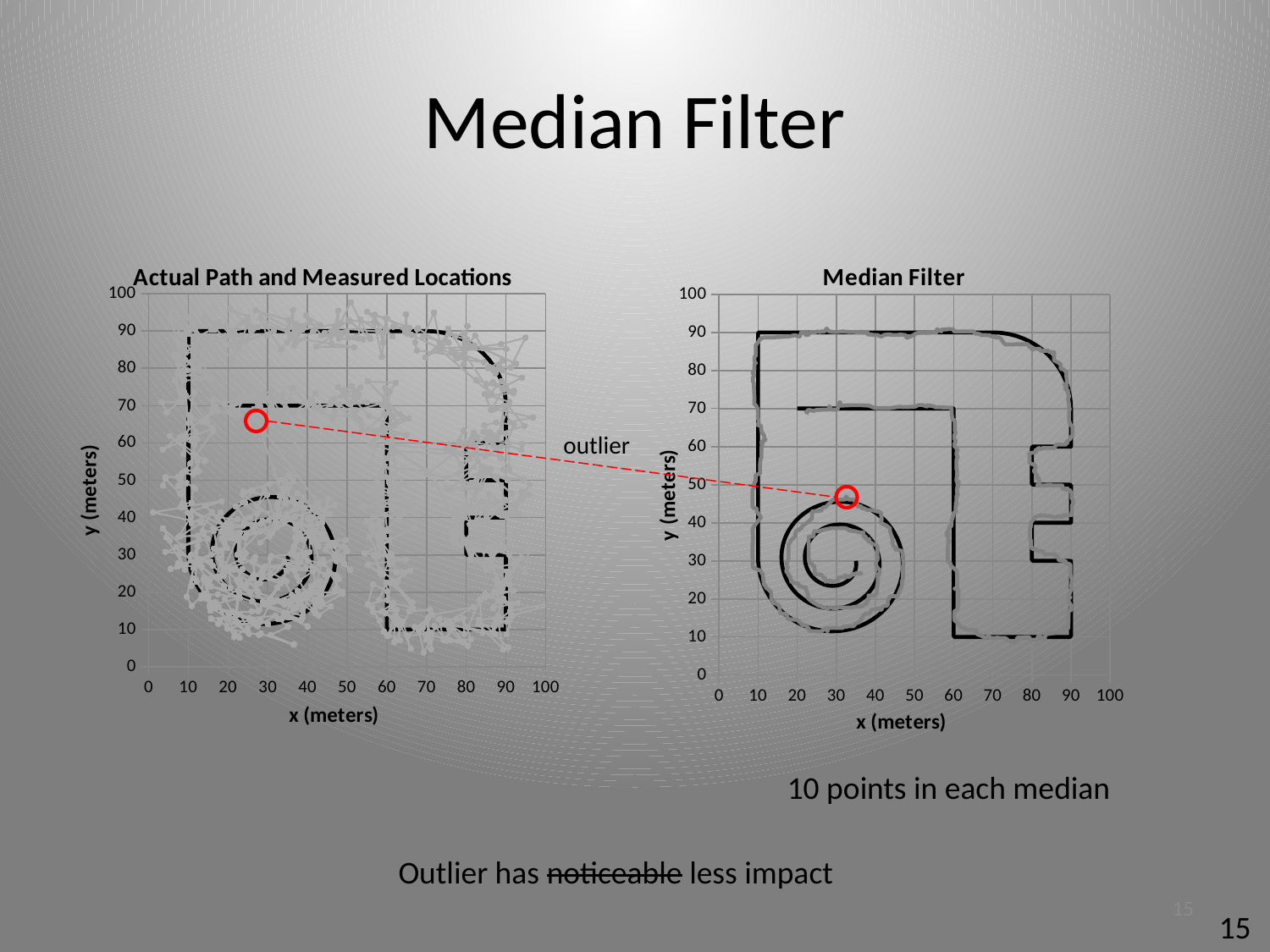
What is the title of the right chart? Median Filter What kind of chart is the left chart titled 'Actual Path and Measured Locations'? scatter chart How many charts are shown on the slide? 2 In the right chart 'Median Filter', is the x value of the circled outlier greater or less than 50? less What kind of chart is the right chart titled 'Median Filter'? scatter chart In the right chart 'Median Filter', is the y value of the circled outlier greater or less than 60? less What is the title of the left chart? Actual Path and Measured Locations In the left chart 'Actual Path and Measured Locations', what is the highest value shown on the x axis? 100 In the left chart 'Actual Path and Measured Locations', is the x value of the circled outlier greater or less than 40? less In the right chart 'Median Filter', what is the highest value shown on the y axis? 100